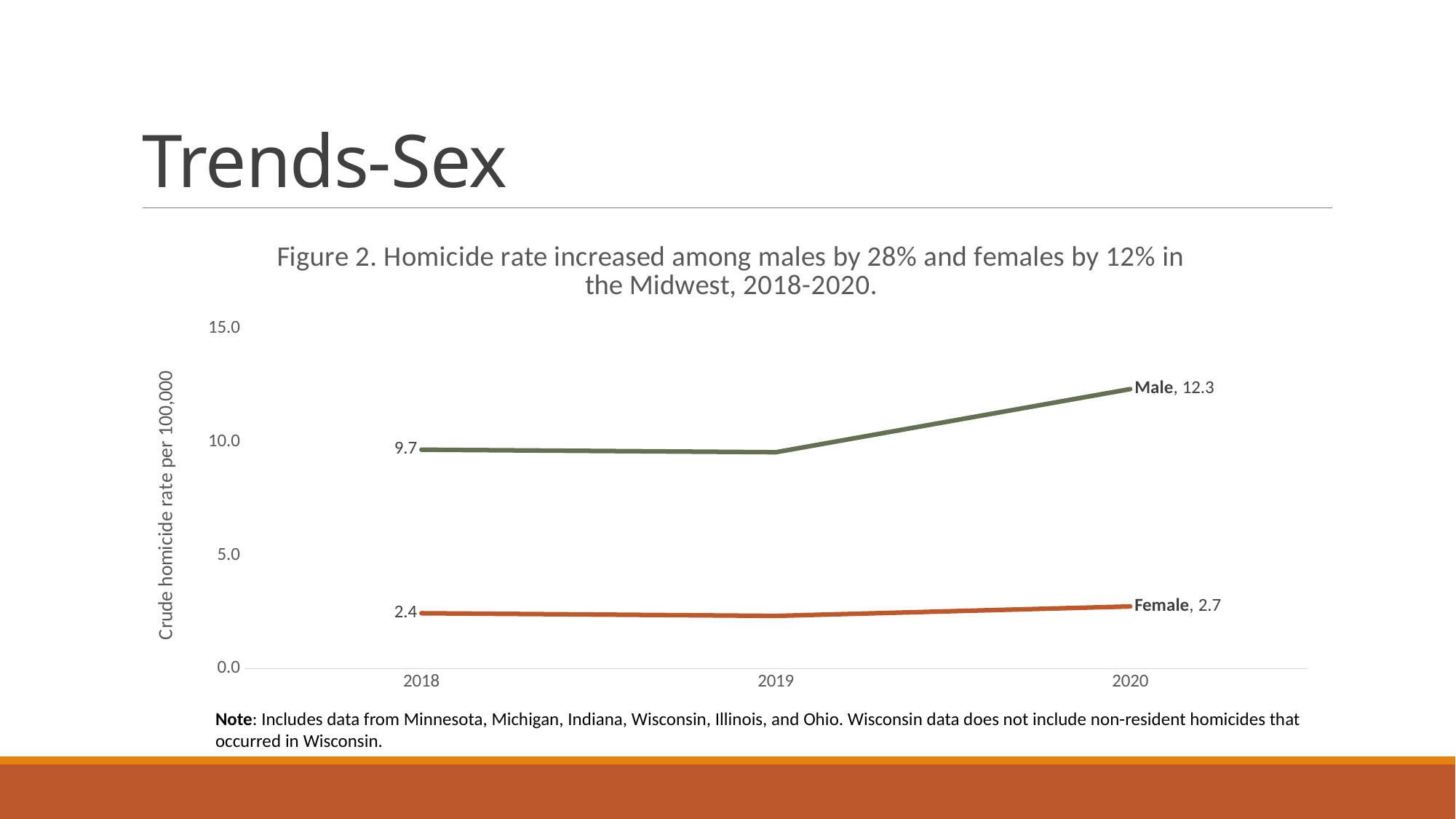
Which series has the higher homicide rate in 2020, Male or Female? Male What is the difference between the male and female homicide rates in 2020? 9.6 What is the label of the y axis? Crude homicide rate per 100,000 What is the male homicide rate in 2020? 12.3 What type of chart is shown on the slide? Line chart By how much did the male homicide rate change from 2018 to 2020? 2.6 Is the male homicide rate in 2019 greater or less than 10.0? less What is the female homicide rate in 2018? 2.4 How many years are shown on the x axis? 3 What is the female homicide rate in 2020? 2.7 What is the male homicide rate in 2018? 9.7 By how much did the female homicide rate change from 2018 to 2020? 0.3